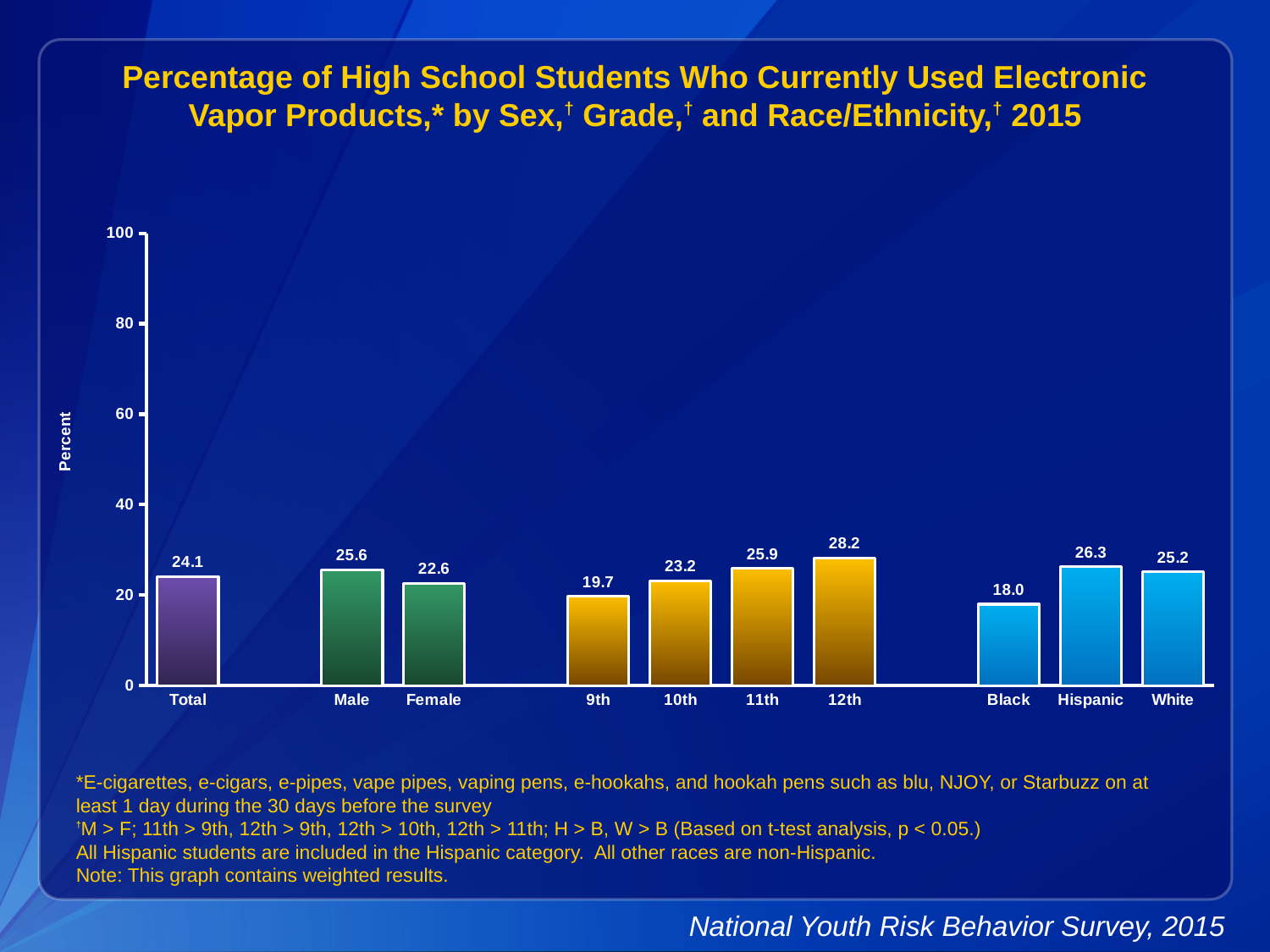
What is the value for Black students? 18.0 What is the value for Female? 22.6 Which category has the lowest value? Black What is the difference between the Male and Female values? 3.0 Which category has the highest value? 12th Is the value for 11th grade greater or less than 20? greater What is the value for Total? 24.1 What is the difference between the 12th and 9th grade values? 8.5 What is the value for 12th grade? 28.2 How many bars are shown in the chart? 10 Which is larger, the value for Hispanic or the value for White? Hispanic What kind of chart is shown on the slide? bar chart